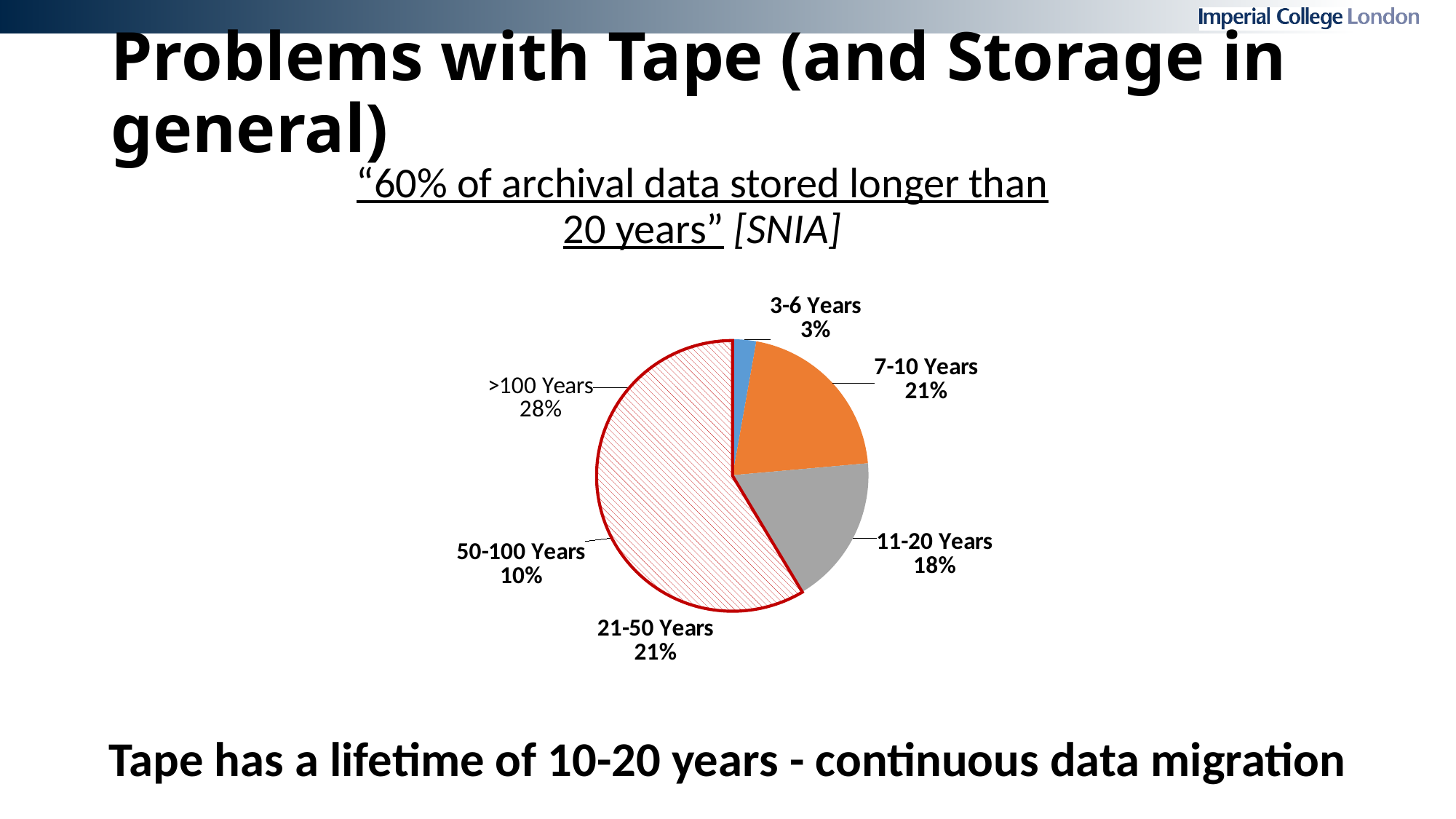
What percentage is shown for the 50-100 Years slice? 10% What percentage is shown for the 11-20 Years slice? 18% Which category has the largest slice of the pie? >100 Years What percentage is shown for the >100 Years slice? 28% What is the combined percentage of the 21-50 Years, 50-100 Years and >100 Years slices? 59% Which category has the smallest slice of the pie? 3-6 Years What share of the pie does the 3-6 Years slice represent? 3% How many slices does the pie chart have? 6 What is the difference in percentage points between the >100 Years slice and the 11-20 Years slice? 10 Which slice of the pie is coloured orange? 7-10 Years Which slice is larger, 11-20 Years or 50-100 Years? 11-20 Years What kind of chart is shown on the slide? Pie chart